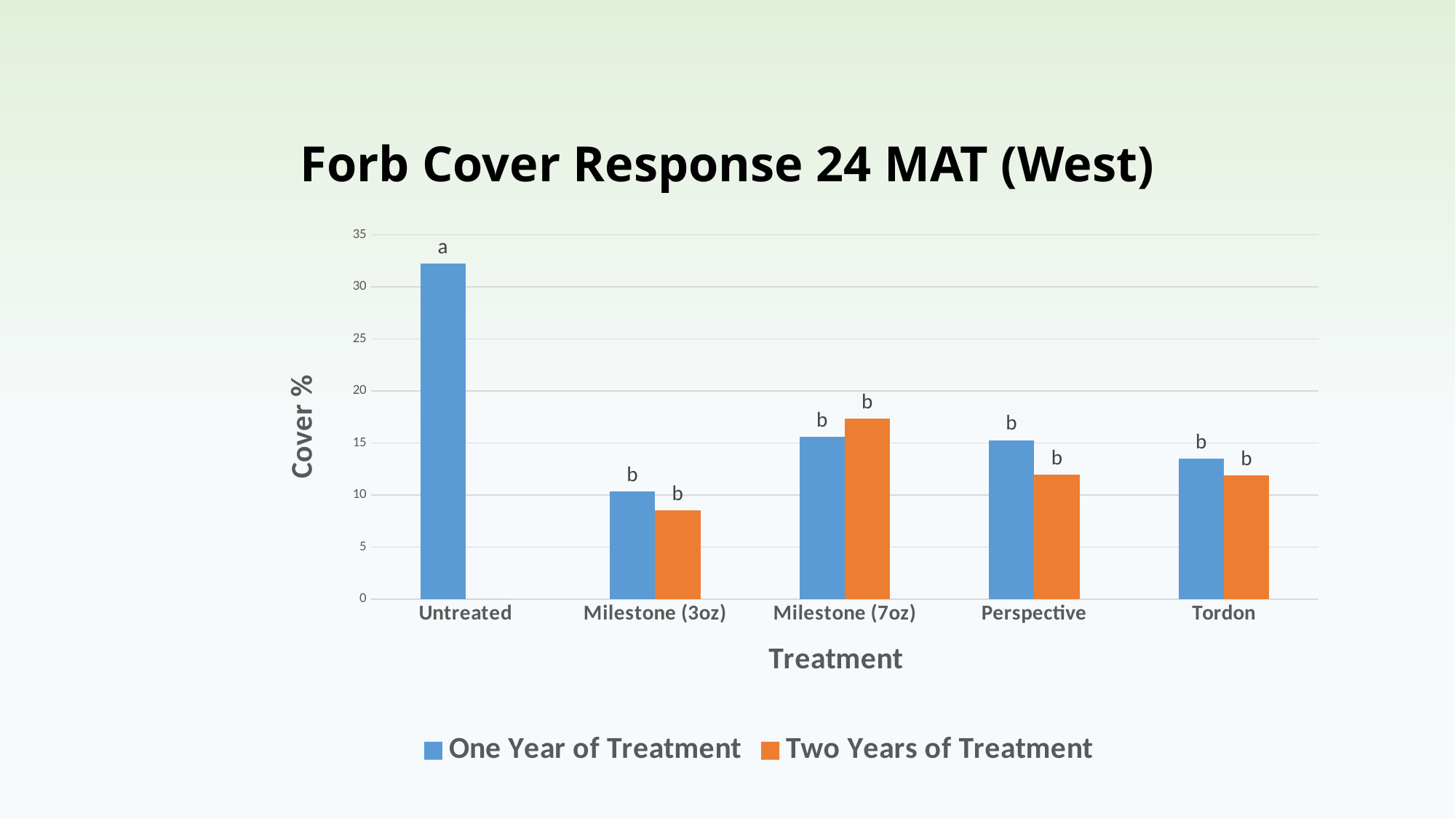
Which treatment has the highest One Year of Treatment cover? Untreated How many series does the legend list? 2 How many treatment categories are shown on the x axis? 5 For Perspective, which is larger: One Year of Treatment or Two Years of Treatment? One Year of Treatment What kind of chart is shown on the slide? bar chart Is the Two Years of Treatment value for Milestone (7oz) greater or less than 15? greater Is the One Year of Treatment value for Untreated greater or less than 30? greater For Milestone (7oz), which is larger: One Year of Treatment or Two Years of Treatment? Two Years of Treatment Is the Two Years of Treatment value for Milestone (3oz) greater or less than 10? less What is the title of the chart? Forb Cover Response 24 MAT (West) Which treatment has the highest Two Years of Treatment cover? Milestone (7oz)